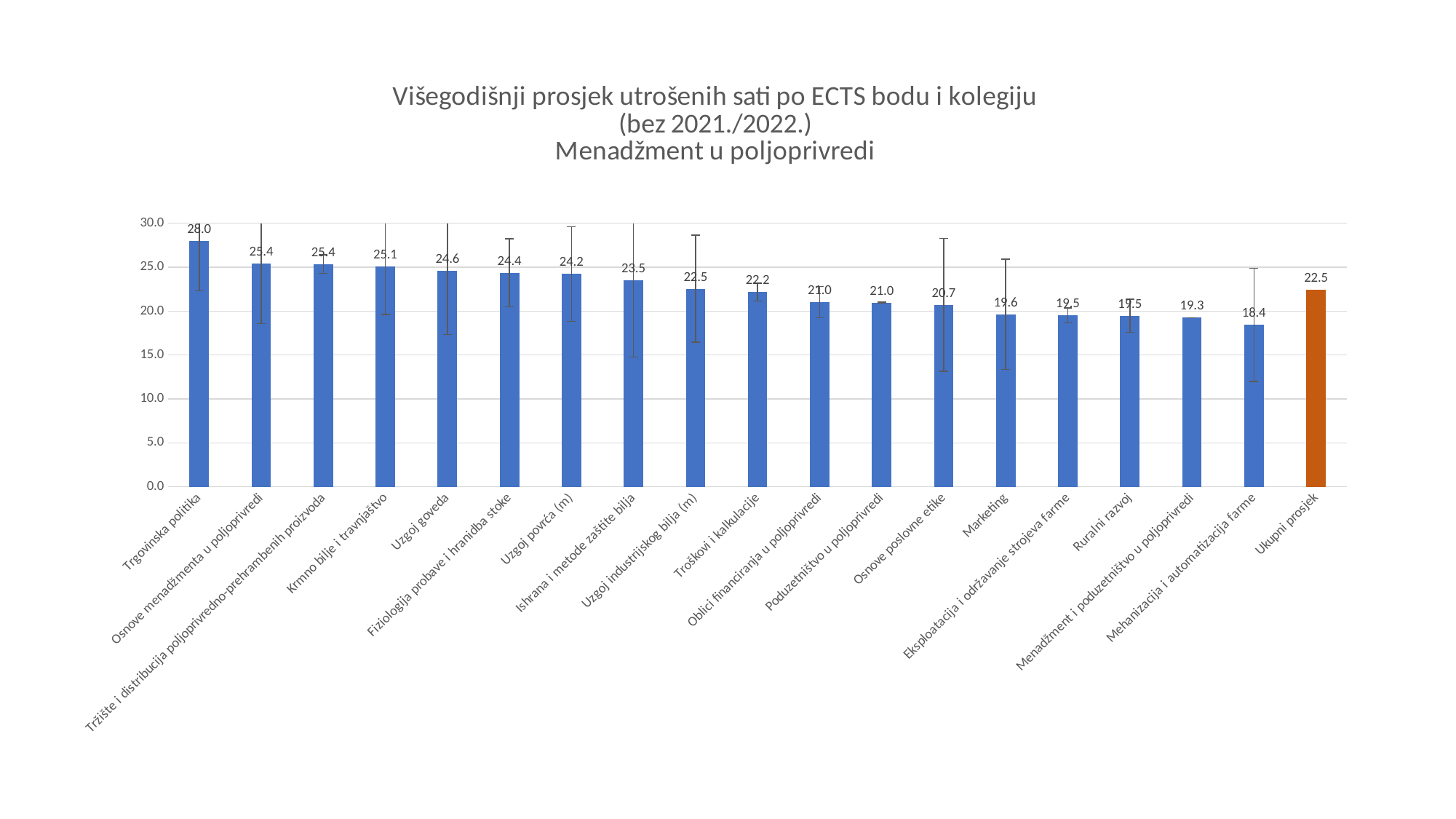
What is the value for Trgovinska politika? 28.0 What is the value for Ukupni prosjek? 22.5 How many bars are plotted in the chart? 19 What is the difference between the values for Trgovinska politika and Ukupni prosjek? 5.5 What kind of chart is shown on the slide? bar chart Which category has the lowest value? Mehanizacija i automatizacija farme What colour is the bar for Ukupni prosjek? orange What is the value for Osnove poslovne etike? 20.7 Which category has the highest value? Trgovinska politika What is the value for Ishrana i metode zaštite bilja? 23.5 Which is larger, the value for Uzgoj goveda or the value for Osnove poslovne etike? Uzgoj goveda What is the difference between the values for Trgovinska politika and Mehanizacija i automatizacija farme? 9.6